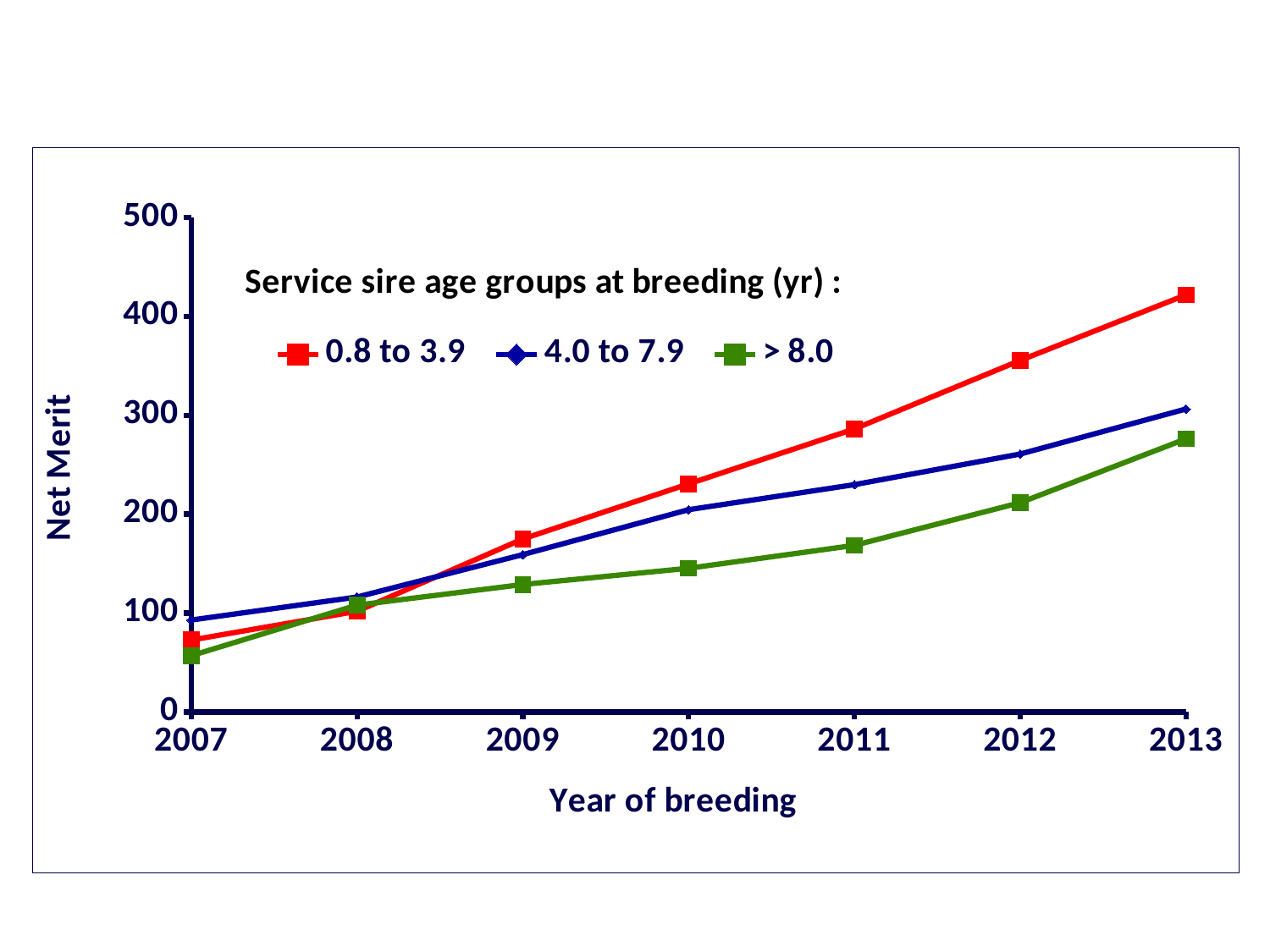
Is the Net Merit for the 0.8 to 3.9 group in 2013 greater or less than 400? greater In 2012, which group has the larger Net Merit: 4.0 to 7.9 or > 8.0? 4.0 to 7.9 Is the Net Merit for the > 8.0 group in 2010 greater or less than 200? less Which service sire age group has the lowest Net Merit in 2013? > 8.0 What kind of chart is shown on the slide? line chart Which service sire age group has the highest Net Merit in 2013? 0.8 to 3.9 What is the label of the y axis? Net Merit How many years are plotted along the x axis? 7 How many series does the legend list? 3 Does the Net Merit for the 0.8 to 3.9 group rise or fall from 2007 to 2013? rise Is the Net Merit for the > 8.0 group in 2013 greater or less than 300? less